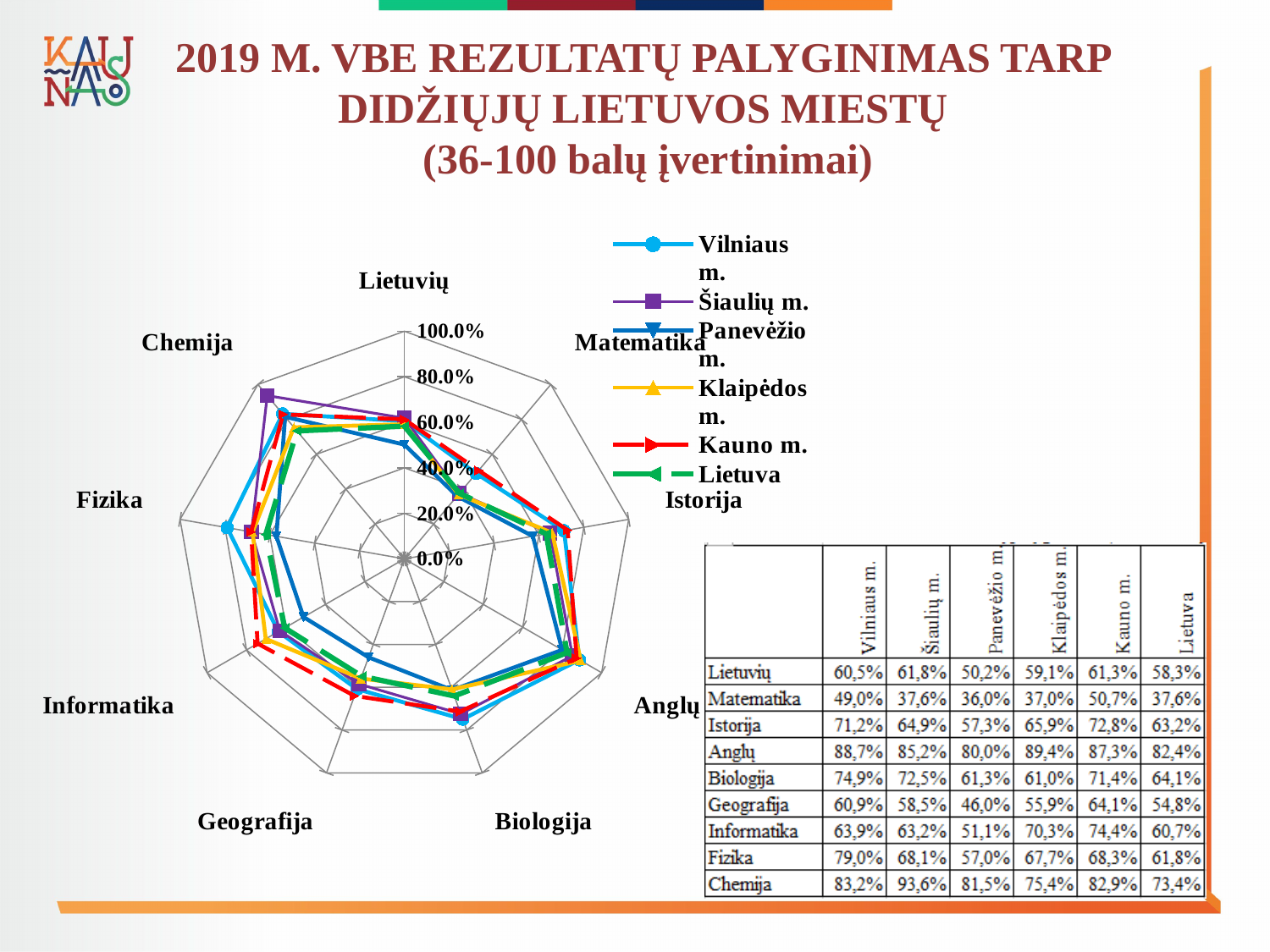
What is the value for Panevėžio m. in Matematika? 36,0% What is the value for Kauno m. in Informatika? 74,4% What is the maximum value shown on the radar chart's axis scale? 100.0% How many series does the legend of the radar chart list? 6 What kind of chart is shown on the slide? Radar chart Which subject has the lowest value for Vilniaus m.? Matematika What is the value for Šiaulių m. in Chemija? 93,6% What is the difference between the Fizika values for Vilniaus m. and Panevėžio m.? 22,0% Which is larger in Anglų: the value for Klaipėdos m. or for Vilniaus m.? Klaipėdos m. Is the value for Kauno m. in Anglų greater or less than 80.0%? greater How many subject categories are plotted on the radar chart? 9 Which series has the highest value in Chemija? Šiaulių m.